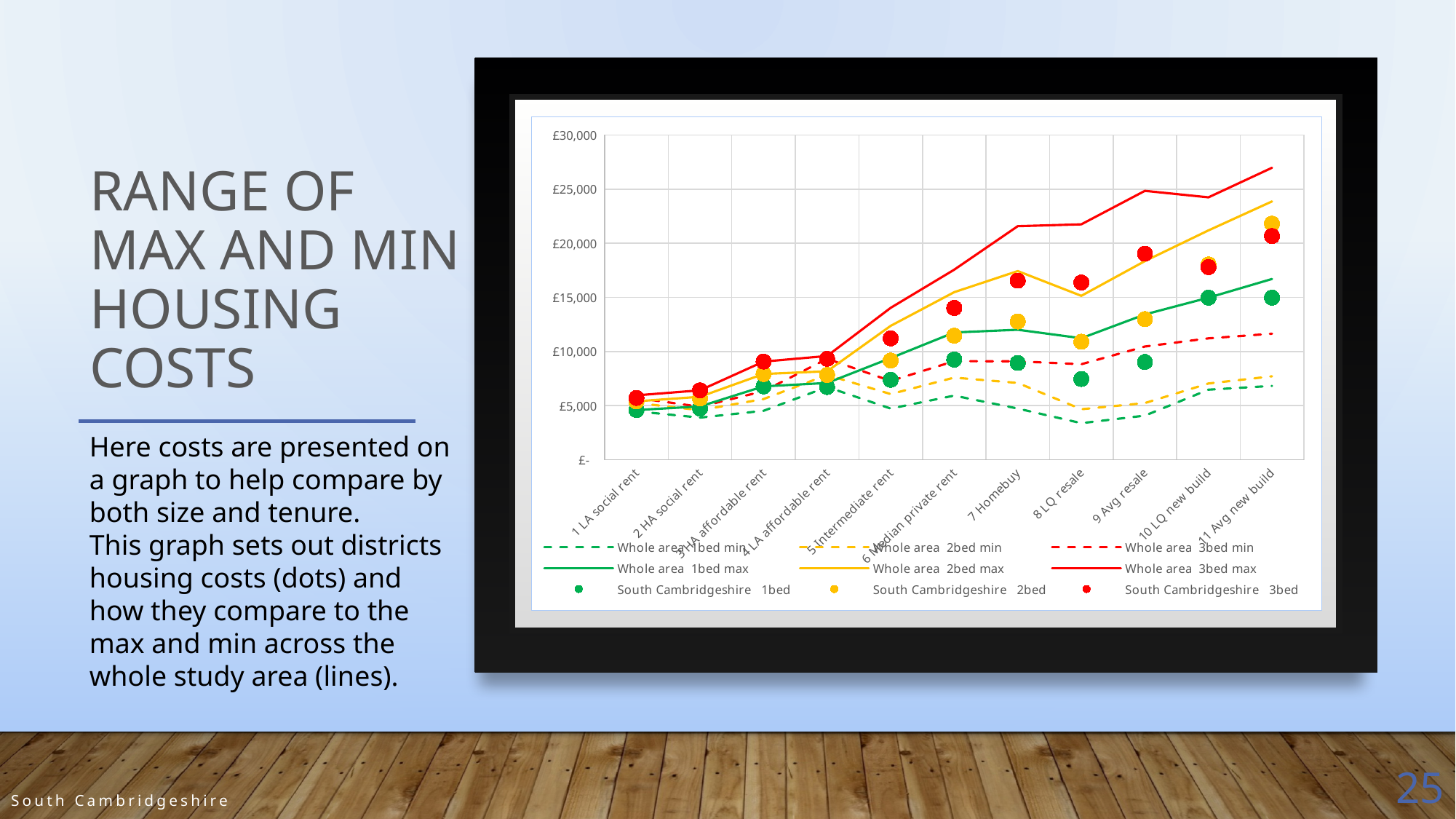
Is the South Cambridgeshire 1bed value at 8 LQ resale greater or less than £10,000? less At 9 Avg resale, which is larger: the South Cambridgeshire 3bed value or the South Cambridgeshire 1bed value? South Cambridgeshire 3bed At which category does the Whole area 3bed max line reach its highest value? 11 Avg new build Is the South Cambridgeshire 2bed value at 7 Homebuy greater or less than £10,000? greater Is the Whole area 3bed max value at 7 Homebuy greater or less than £20,000? greater How many categories are shown along the x axis of the chart? 11 What colour are the 3bed series drawn in on the chart? red How many series does the chart's legend list? 9 Does the Whole area 3bed max line generally rise or fall from 1 LA social rent to 11 Avg new build? rise What kind of chart is shown on the slide? line chart